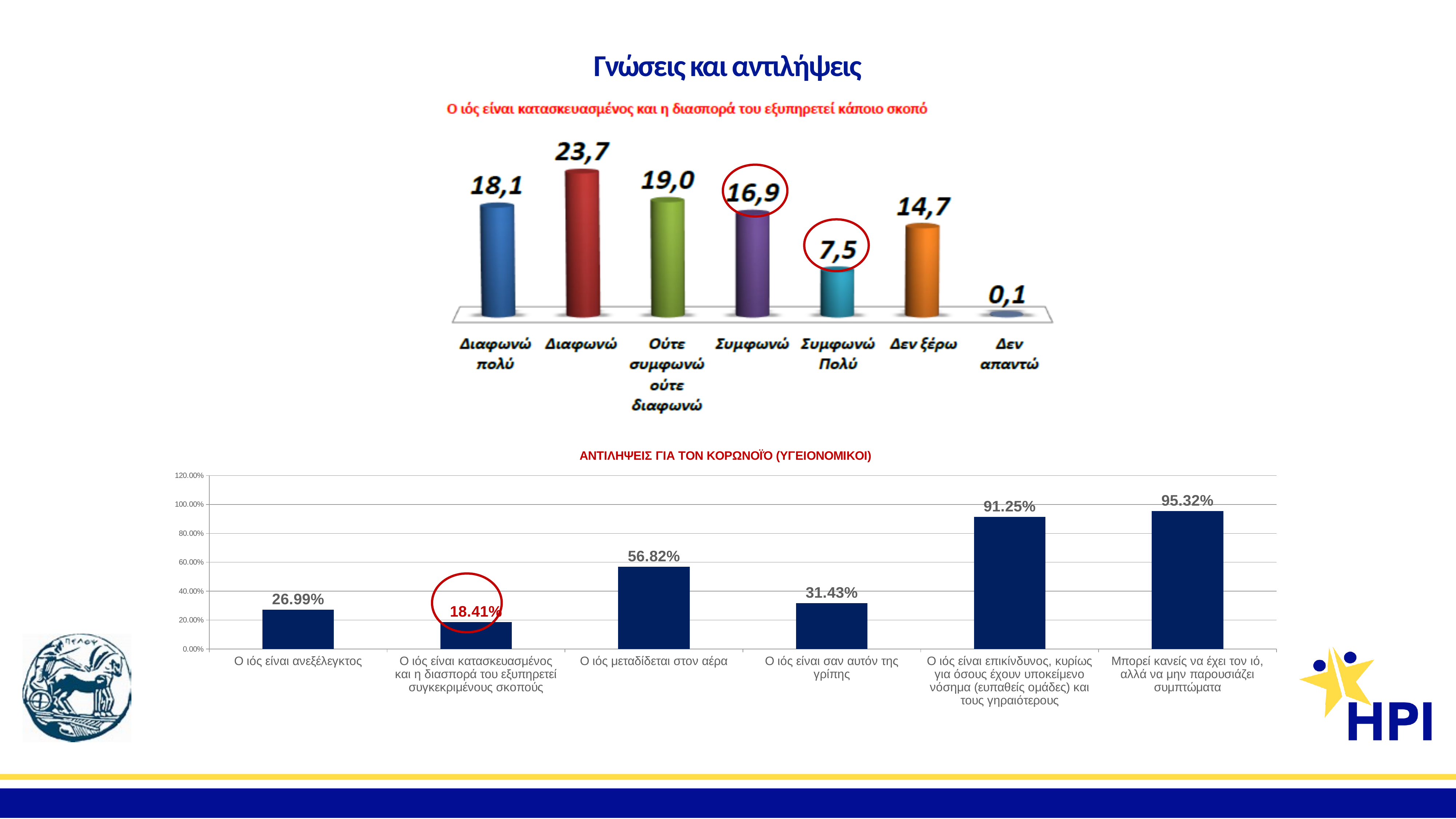
In the top chart, which category has the highest value? Διαφωνώ What kind of chart is the bottom chart? Bar chart In the bottom chart, which is larger: Ο ιός είναι ανεξέλεγκτος or Ο ιός είναι κατασκευασμένος και η διασπορά του εξυπηρετεί συγκεκριμένους σκοπούς? Ο ιός είναι ανεξέλεγκτος In the top chart, what is the difference between Διαφωνώ πολύ and Δεν ξέρω? 3,4 In the top chart, what is the value for Συμφωνώ Πολύ? 7,5 In the bottom chart, what is the difference between Μπορεί κανείς να έχει τον ιό, αλλά να μην παρουσιάζει συμπτώματα and Ο ιός είναι επικίνδυνος, κυρίως για όσους έχουν υποκείμενο νόσημα? 4.07% In the bottom chart, what is the value for Ο ιός είναι σαν αυτόν της γρίπης? 31.43% In the top chart (Ο ιός είναι κατασκευασμένος και η διασπορά του εξυπηρετεί κάποιο σκοπό), what is the value for Διαφωνώ? 23,7 In the bottom chart (ΑΝΤΙΛΗΨΕΙΣ ΓΙΑ ΤΟΝ ΚΟΡΩΝΟΪΟ (ΥΓΕΙΟΝΟΜΙΚΟΙ)), what is the value for Ο ιός μεταδίδεται στον αέρα? 56.82% In the bottom chart, which category has the highest value? Μπορεί κανείς να έχει τον ιό, αλλά να μην παρουσιάζει συμπτώματα In the top chart, how many categories are shown? 7 In the top chart, which category has the lowest value? Δεν απαντώ